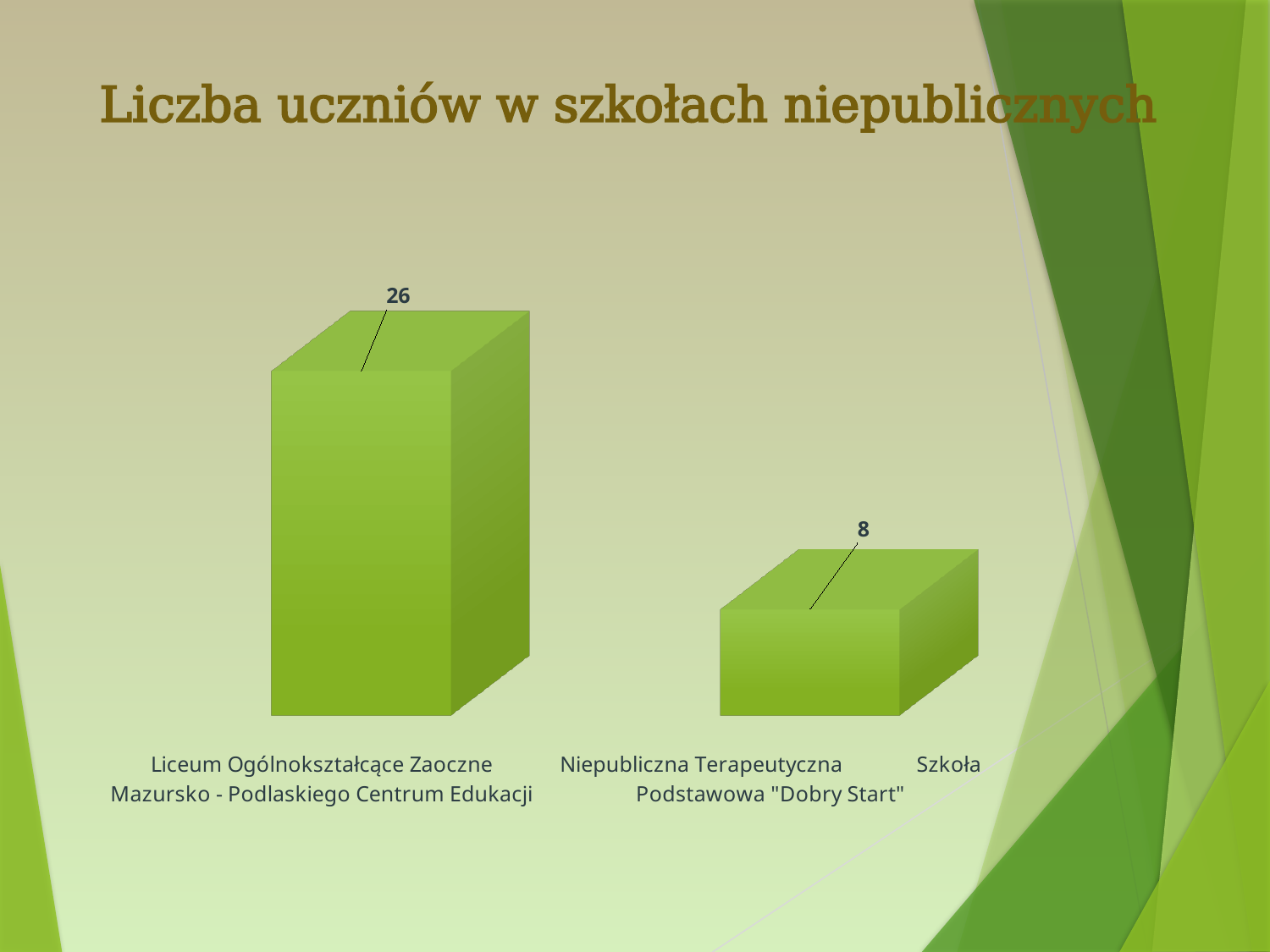
What is the title of the slide containing the chart? Liczba uczniów w szkołach niepublicznych Is the value for Niepubliczna Terapeutyczna Szkoła Podstawowa "Dobry Start" larger or smaller than the value for Liceum Ogólnokształcące Zaoczne? smaller What colour are the bars in the chart? green Which school has the lower number of students in the chart? Niepubliczna Terapeutyczna Szkoła Podstawowa "Dobry Start" Which school has the higher number of students in the chart? Liceum Ogólnokształcące Zaoczne Mazursko - Podlaskiego Centrum Edukacji What kind of chart is shown on the slide? bar chart How many students does the chart show for Niepubliczna Terapeutyczna Szkoła Podstawowa "Dobry Start"? 8 How many students does the chart show for Liceum Ogólnokształcące Zaoczne Mazursko - Podlaskiego Centrum Edukacji? 26 What is the difference in the number of students between the Liceum Ogólnokształcące Zaoczne and the Niepubliczna Terapeutyczna Szkoła Podstawowa "Dobry Start"? 18 What is the total number of students across both schools shown in the chart? 34 How many schools (categories) are shown in the chart? 2